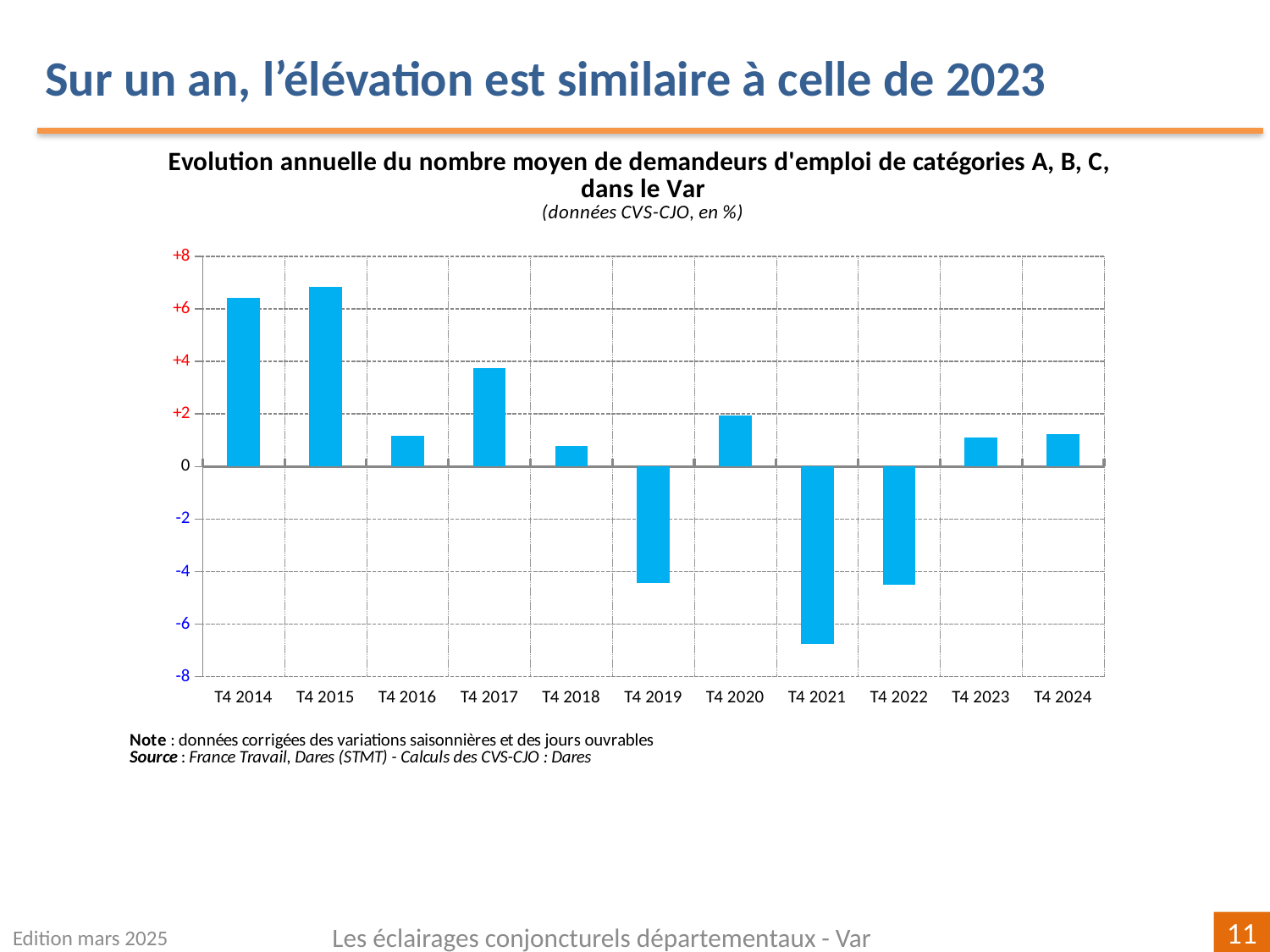
Is the value for T4 2019 greater or less than -4? less Which is larger, the value for T4 2017 or the value for T4 2016? T4 2017 What kind of chart is shown on the slide? bar chart Which category has the highest value? T4 2015 Is the value for T4 2021 greater or less than -6? less Is the value for T4 2014 greater or less than +6? greater How many categories (quarters) are plotted on the x axis? 11 In what unit are the data expressed, according to the chart subtitle? en % Which category has the lowest value? T4 2021 Which is larger, the value for T4 2020 or the value for T4 2018? T4 2020